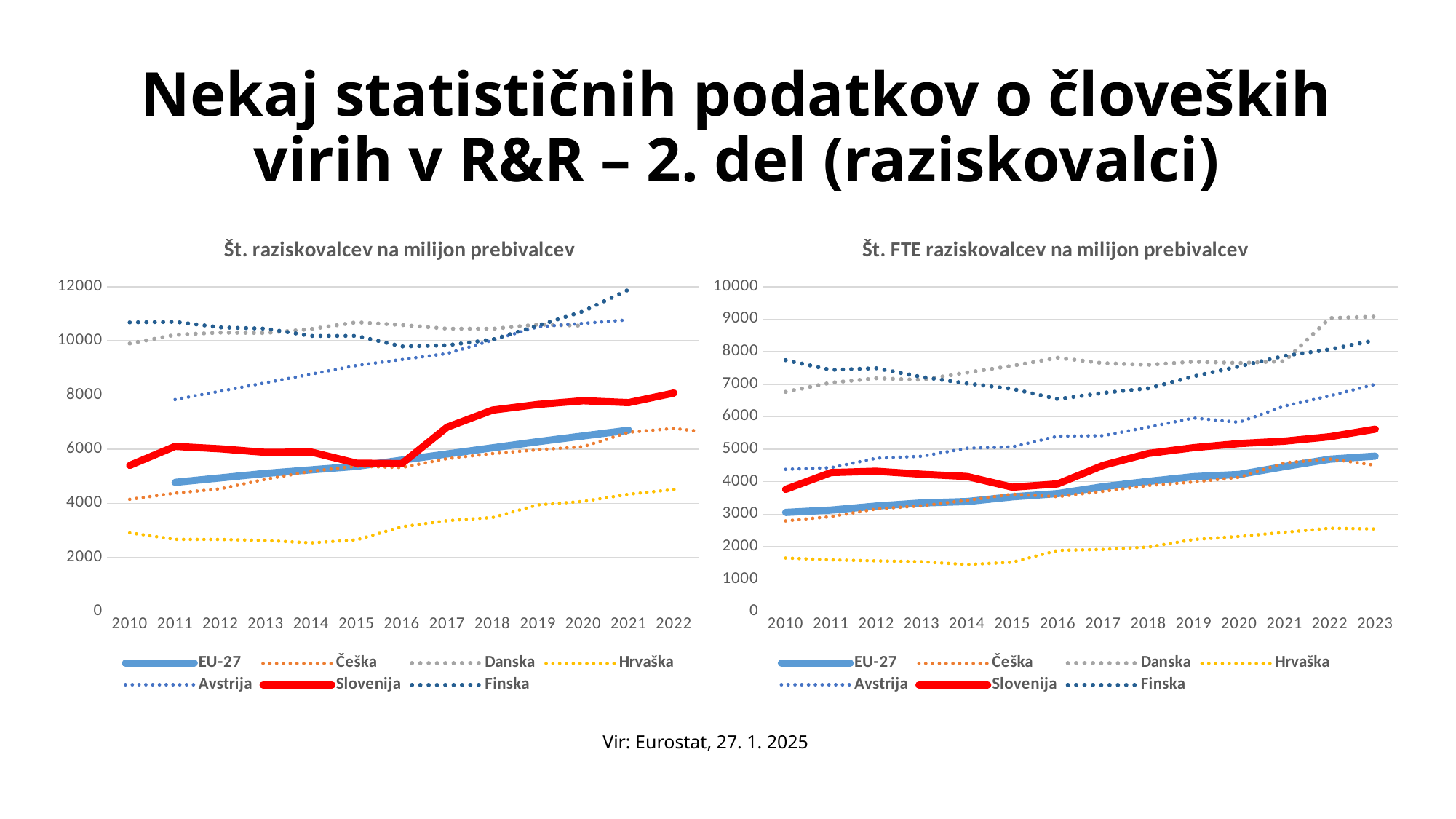
In the left chart, 'Št. raziskovalcev na milijon prebivalcev', is the value for Finska in 2021 greater or less than 10000? greater In the right chart, 'Št. FTE raziskovalcev na milijon prebivalcev', does the EU-27 series rise or fall from 2010 to 2023? rise In the left chart, 'Št. raziskovalcev na milijon prebivalcev', which is larger in 2021: Finska or Avstrija? Finska How many series does the legend of the right chart, 'Št. FTE raziskovalcev na milijon prebivalcev', list? 7 In the left chart, 'Št. raziskovalcev na milijon prebivalcev', which series has the lowest value in 2010? Hrvaška What kind of chart is the left chart, 'Št. raziskovalcev na milijon prebivalcev'? line chart In the right chart, 'Št. FTE raziskovalcev na milijon prebivalcev', which series has the highest value in 2023? Danska How many years are shown on the x axis of the left chart, 'Št. raziskovalcev na milijon prebivalcev'? 13 In the right chart, 'Št. FTE raziskovalcev na milijon prebivalcev', is the value for Danska in 2022 greater or less than 8000? greater In the left chart, 'Št. raziskovalcev na milijon prebivalcev', is the value for Hrvaška in 2010 greater or less than 4000? less How many years are shown on the x axis of the right chart, 'Št. FTE raziskovalcev na milijon prebivalcev'? 14